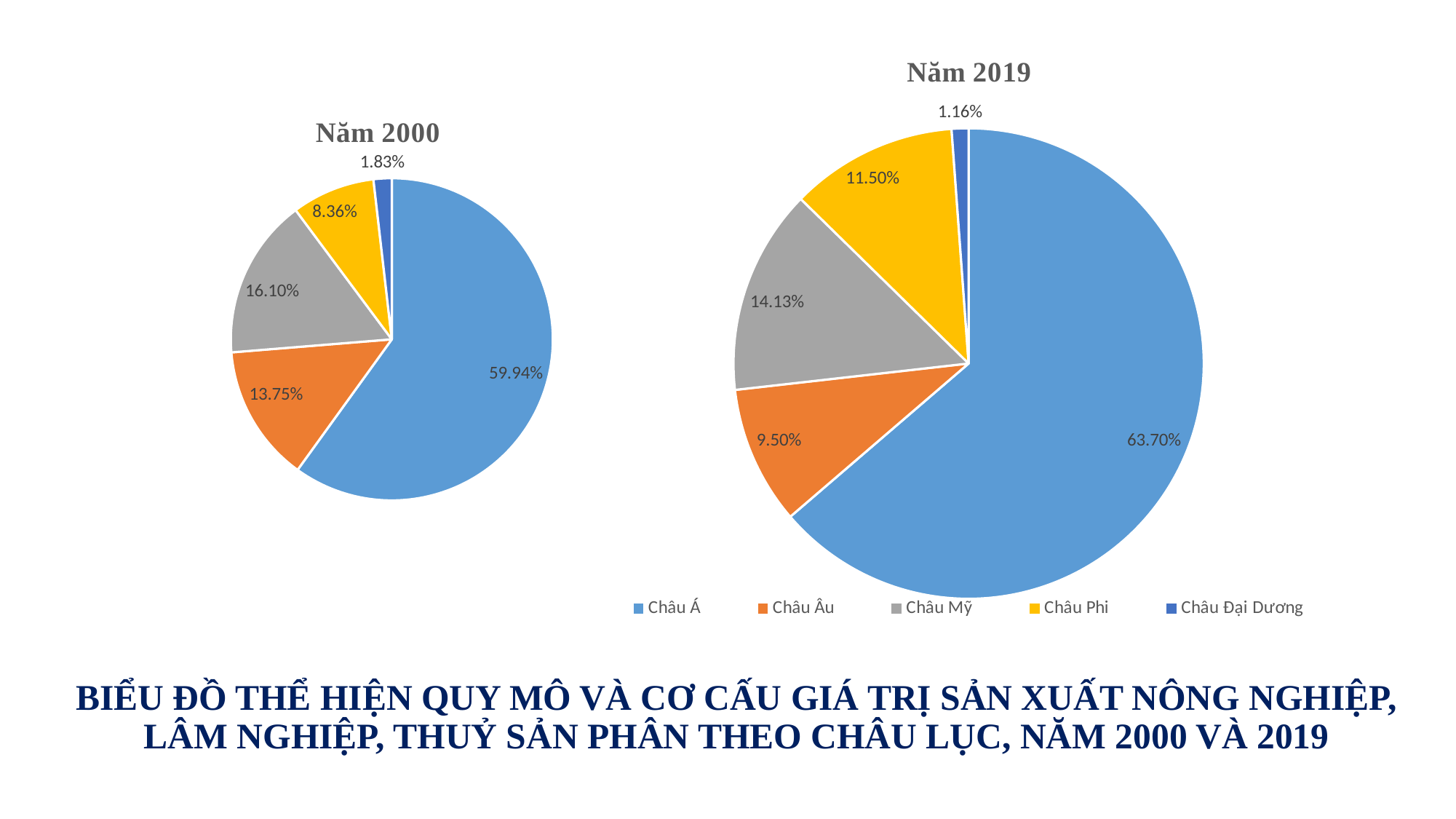
In the 'Năm 2019' pie chart, what is the difference between the shares of Châu Á and Châu Phi? 52.20% How many entries does the legend list? 5 In the 'Năm 2000' pie chart, which is larger: the share of Châu Âu or the share of Châu Phi? Châu Âu In the 'Năm 2000' pie chart, what share does Châu Á have? 59.94% In the 'Năm 2000' pie chart, what is the difference between the shares of Châu Mỹ and Châu Âu? 2.35% In the 'Năm 2019' pie chart, what share does Châu Mỹ have? 14.13% In the 'Năm 2019' pie chart, which continent has the largest share? Châu Á In the 'Năm 2000' pie chart, which continent has the smallest share? Châu Đại Dương In the 'Năm 2000' pie chart, what share does Châu Phi have? 8.36% How many slices does the 'Năm 2019' pie chart have? 5 What type of chart is used for 'Năm 2000'? Pie chart In the 'Năm 2019' pie chart, what share does Châu Đại Dương have? 1.16%